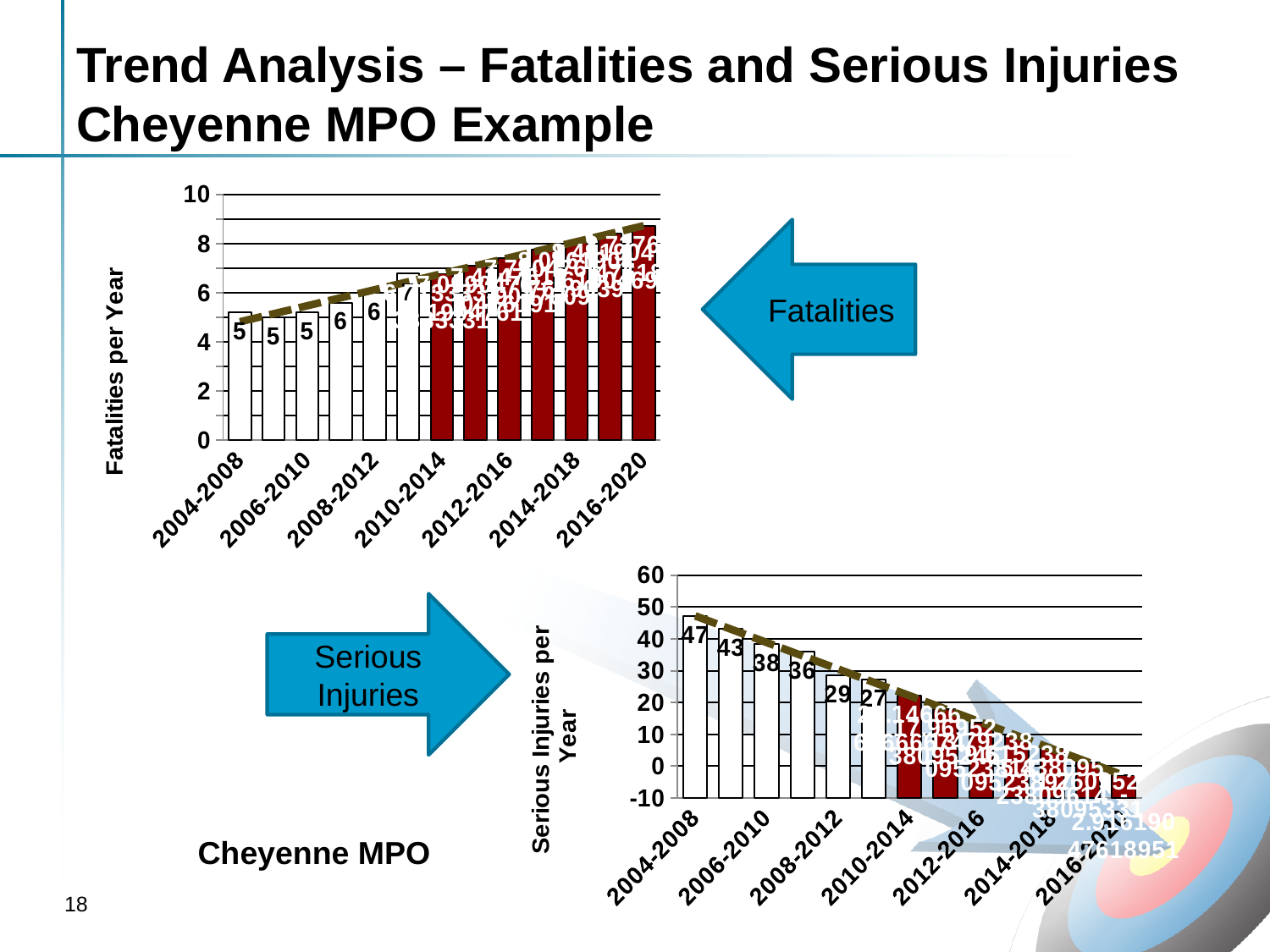
In the Fatalities per Year chart, what is the value for 2004-2008? 5 In the Fatalities per Year chart, which period has the highest value? 2016-2020 In the Serious Injuries per Year chart, what is the value for 2004-2008? 47 In the Serious Injuries per Year chart, which period has the highest value? 2004-2008 In the Serious Injuries per Year chart, what is the difference between the values for 2004-2008 and 2008-2012? 18 In the Serious Injuries per Year chart, what is the value for 2006-2010? 38 What kind of chart is the Fatalities per Year chart? bar chart In the Serious Injuries per Year chart, do the values rise or fall from left to right along the x axis? fall In the Serious Injuries per Year chart, what is the value for 2008-2012? 29 In the Fatalities per Year chart, do the values rise or fall from left to right along the x axis? rise In the Fatalities per Year chart, what is the value for 2008-2012? 6 In the Fatalities per Year chart, is the value for 2016-2020 greater or less than 8? greater